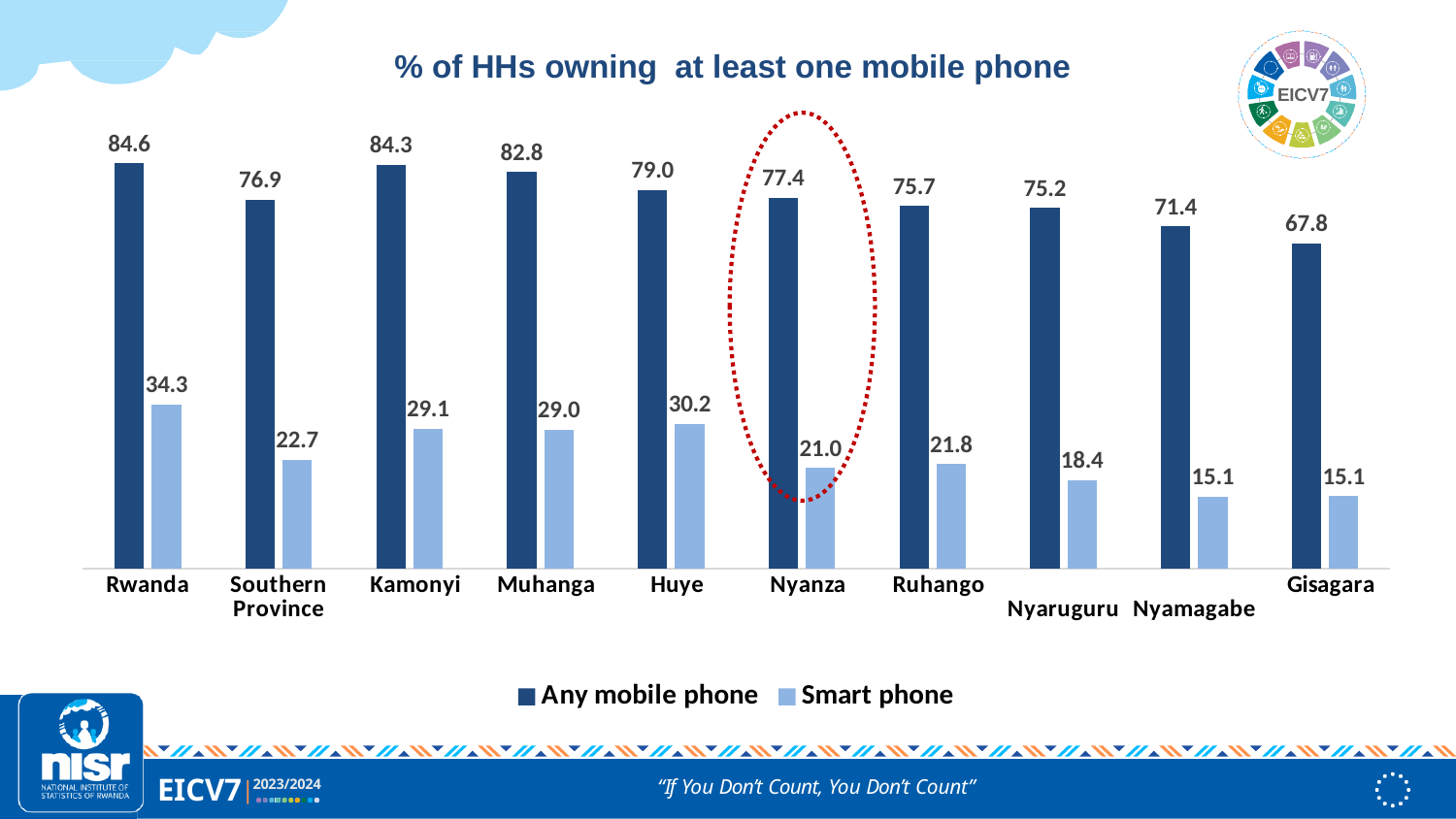
What is the Smart phone value for Huye? 30.2 Which category has the lowest Any mobile phone value? Gisagara Which category is highlighted with a red dotted circle? Nyanza What is the Any mobile phone value for Gisagara? 67.8 How many series does the legend list? 2 Which category has the highest Smart phone value? Rwanda Which category has the highest Any mobile phone value? Rwanda How many categories are shown on the x axis? 10 Which has a larger Smart phone value, Huye or Kamonyi? Huye What is the difference between the Any mobile phone and Smart phone values for Nyanza? 56.4 What is the difference between the Any mobile phone values for Kamonyi and Gisagara? 16.5 What is the value for Any mobile phone in Nyanza? 77.4